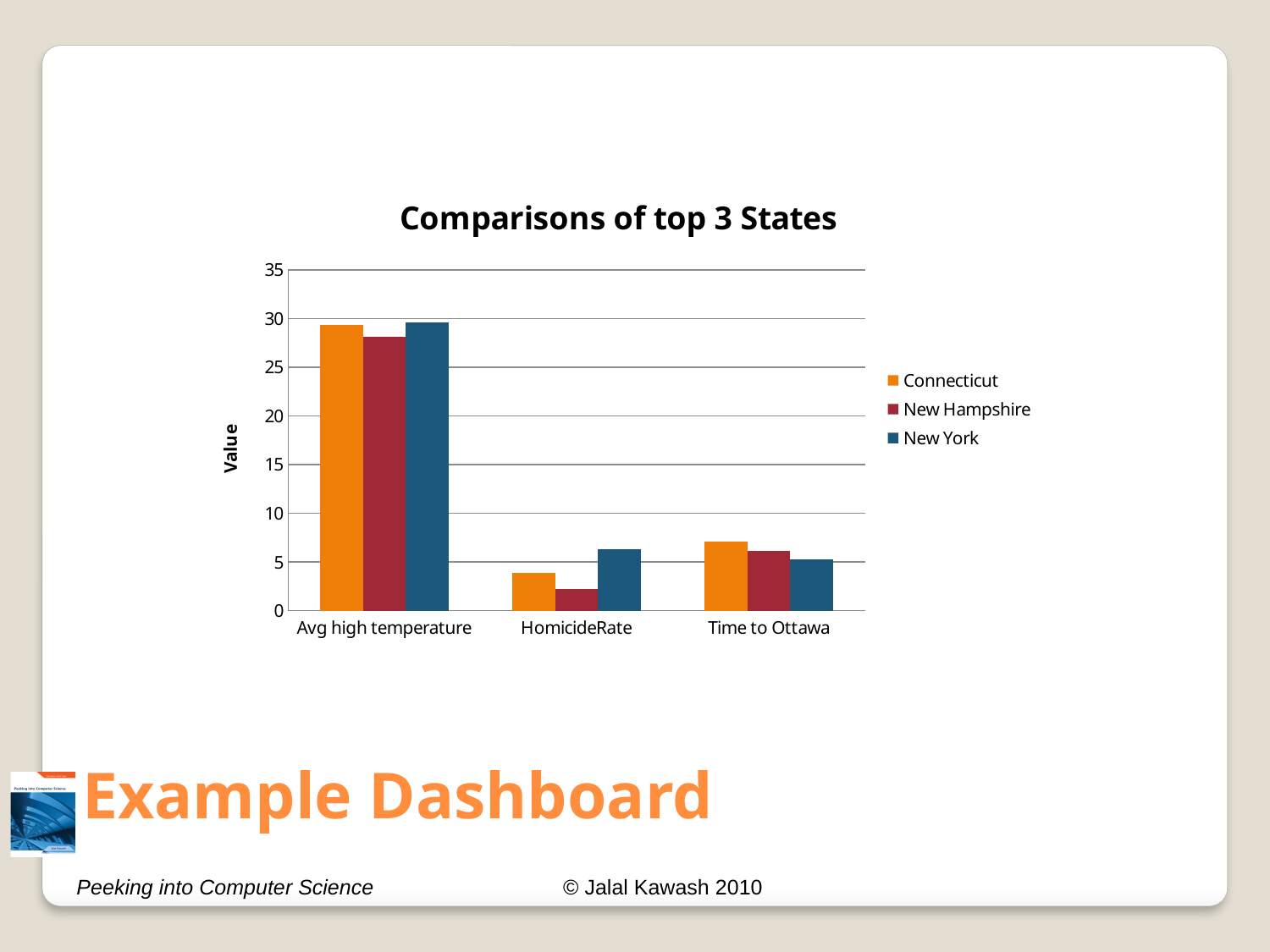
Which state has the highest value for HomicideRate? New York Which state has the lowest value for HomicideRate? New Hampshire How many categories are shown on the x axis? 3 How many series does the legend list? 3 What kind of chart is shown on the slide? bar chart Is the value for New York in HomicideRate greater or less than 5? greater Is the value for Connecticut in Avg high temperature greater or less than 25? greater Which state has the lowest value for Avg high temperature? New Hampshire For Time to Ottawa, which is larger: the value for Connecticut or the value for New York? Connecticut What is the title of the chart? Comparisons of top 3 States Is the value for New Hampshire in HomicideRate greater or less than 5? less Which state has the highest value for Time to Ottawa? Connecticut